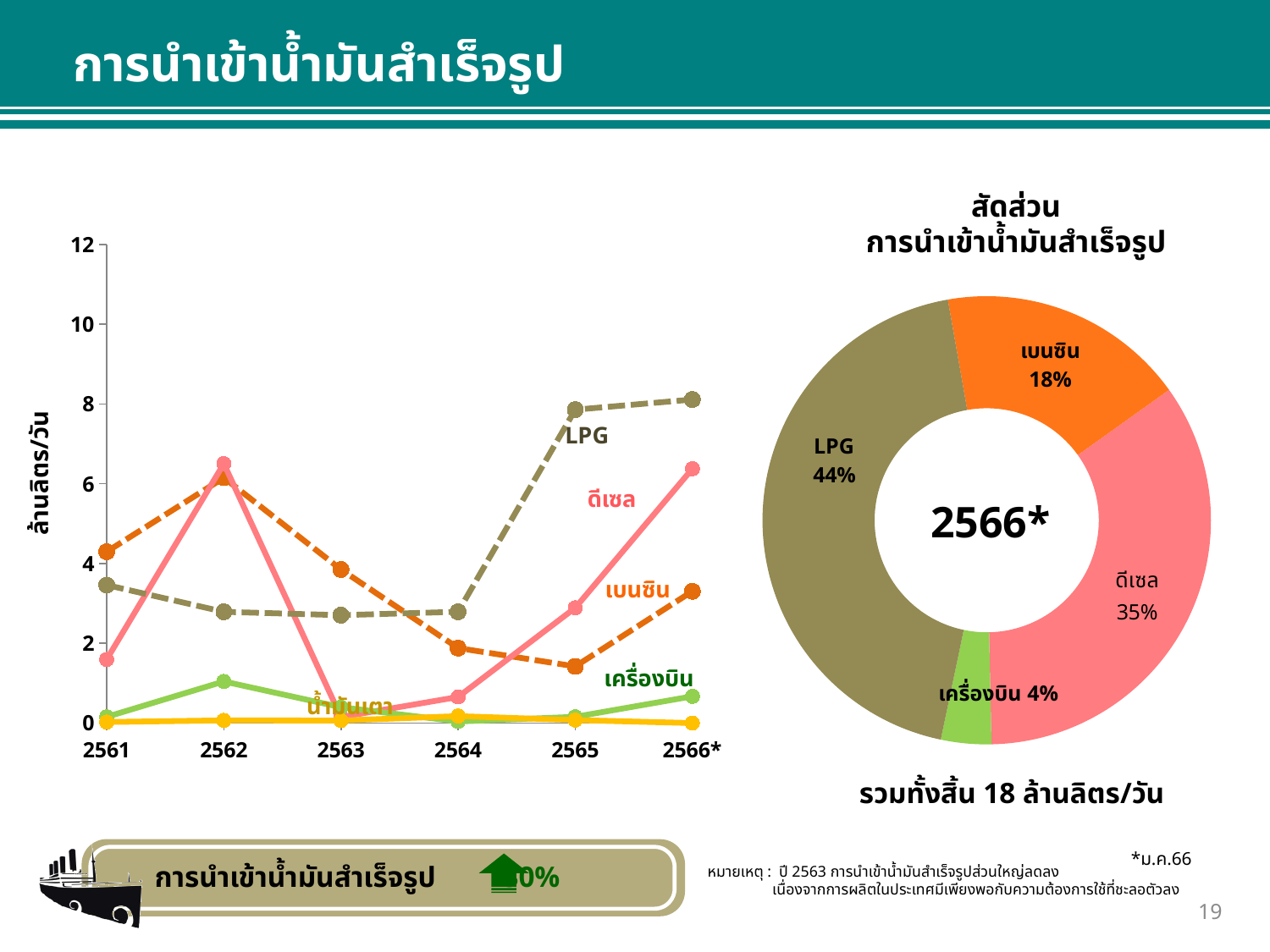
In the line chart on the left, does the LPG line rise or fall from 2564 to 2566*? rise In the donut chart titled สัดส่วนการนำเข้าน้ำมันสำเร็จรูป, how many categories are shown? 4 In the donut chart titled สัดส่วนการนำเข้าน้ำมันสำเร็จรูป, what share does ดีเซล have? 35% In the line chart on the left, is the value for เบนซิน in 2565 greater or less than 2? less What kind of chart is the chart on the right side of the slide? Donut (pie) chart In the donut chart titled สัดส่วนการนำเข้าน้ำมันสำเร็จรูป, what share does LPG have? 44% In the donut chart titled สัดส่วนการนำเข้าน้ำมันสำเร็จรูป, which category has the largest share? LPG In the line chart on the left, is the value for ดีเซล in 2562 greater or less than 6? greater In the donut chart titled สัดส่วนการนำเข้าน้ำมันสำเร็จรูป, how many percentage points larger is the LPG share than the เบนซิน share? 26 In the line chart on the left, how many years are shown on the x axis? 6 In the donut chart titled สัดส่วนการนำเข้าน้ำมันสำเร็จรูป, which category has the smallest share? เครื่องบิน